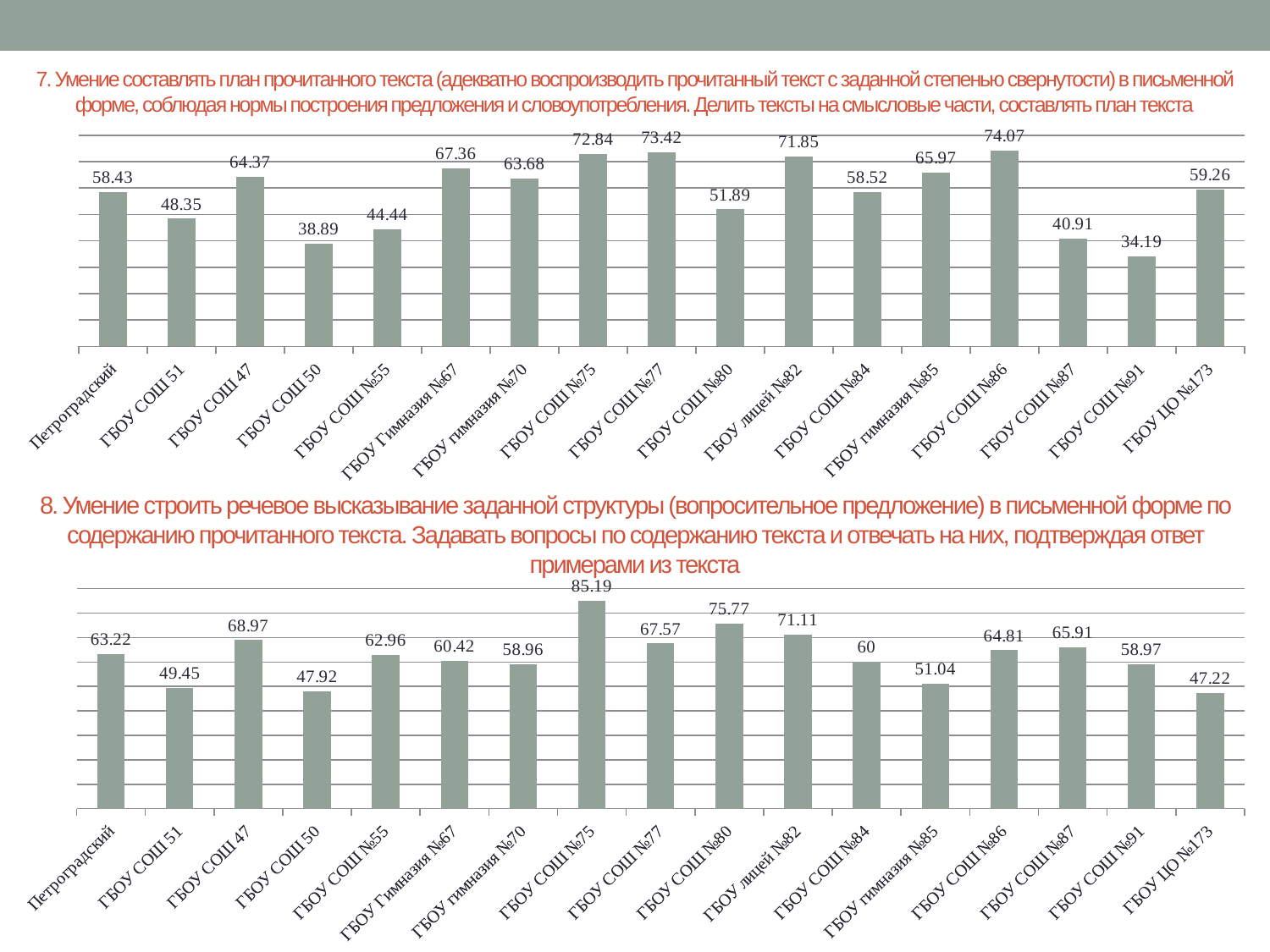
In the bottom chart (skill 8), which school has the highest value? ГБОУ СОШ №75 In the top chart (skill 7), which school has the highest value? ГБОУ СОШ №86 In the bottom chart (skill 8), what is the difference between the values for ГБОУ СОШ №75 and ГБОУ СОШ №80? 9.42 In the bottom chart (skill 8), which is larger: the value for ГБОУ СОШ 47 or the value for ГБОУ лицей №82? ГБОУ лицей №82 In the top chart (skill 7), what is the value for ГБОУ СОШ №75? 72.84 In the bottom chart (skill 8), what is the value for ГБОУ СОШ №84? 60 How many schools (categories) are shown in the top chart (skill 7)? 17 In the top chart (skill 7), what is the value for Петроградский? 58.43 In the top chart (skill 7), which school has the lowest value? ГБОУ СОШ №91 What type of chart is the bottom chart (skill 8)? Bar chart In the bottom chart (skill 8), which school has the lowest value? ГБОУ ЦО №173 In the top chart (skill 7), what is the difference between the values for ГБОУ СОШ №86 and ГБОУ СОШ №91? 39.88